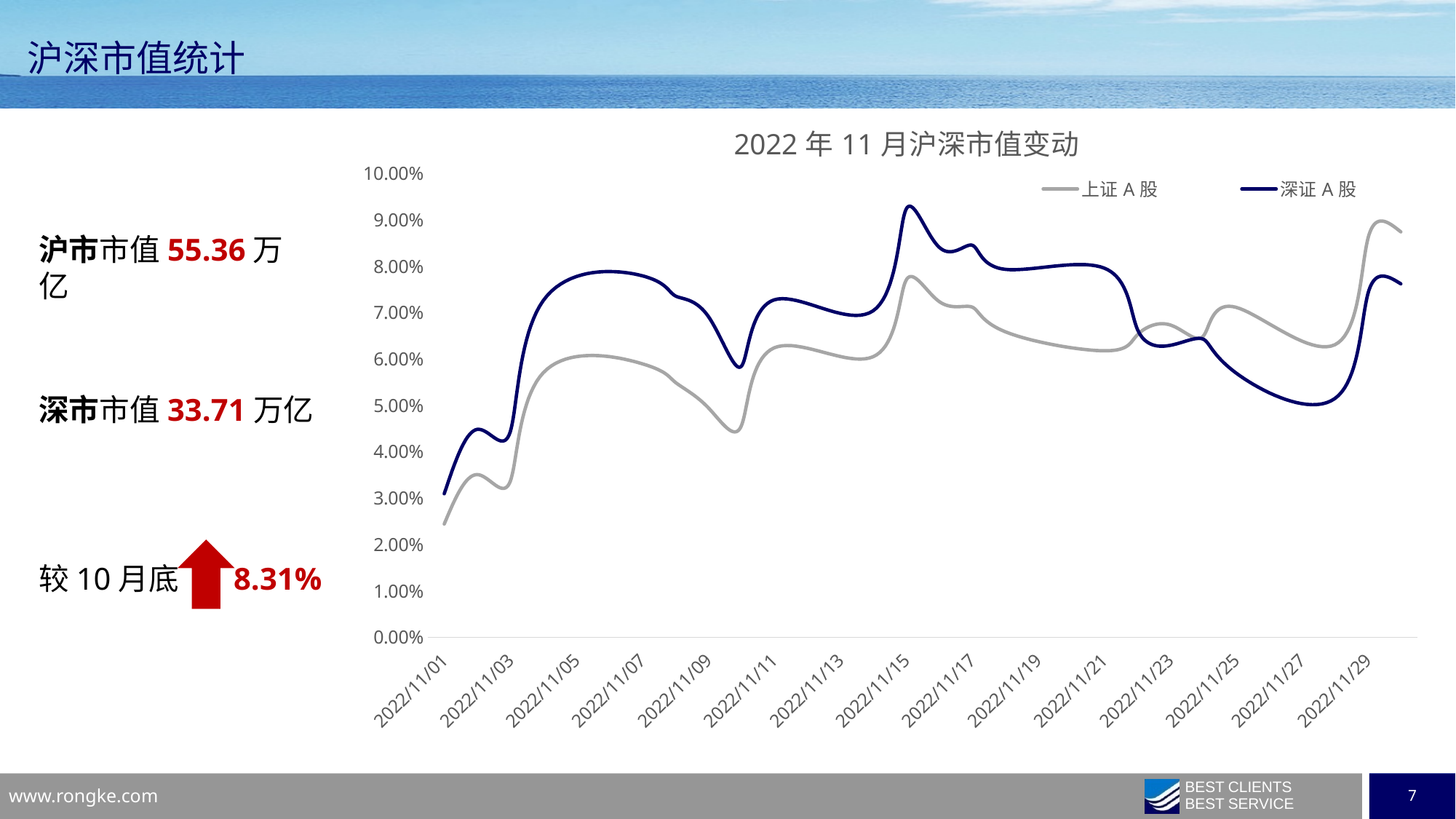
On 2022/11/15, which series has the higher value, 上证A股 or 深证A股? 深证A股 Which series is drawn in dark blue in the chart? 深证A股 How many series does the chart legend list? 2 Does the 深证A股 line rise or fall from 2022/11/21 to 2022/11/27? fall Is the value for 上证A股 on 2022/11/01 greater or less than 3.00%? less On which date does 深证A股 reach its highest value? 2022/11/15 What kind of chart is shown on the slide? line chart On 2022/11/25, which series has the higher value, 上证A股 or 深证A股? 上证A股 What is the title of the chart? 2022年11月沪深市值变动 Is the value for 深证A股 on 2022/11/15 greater or less than 9.00%? greater